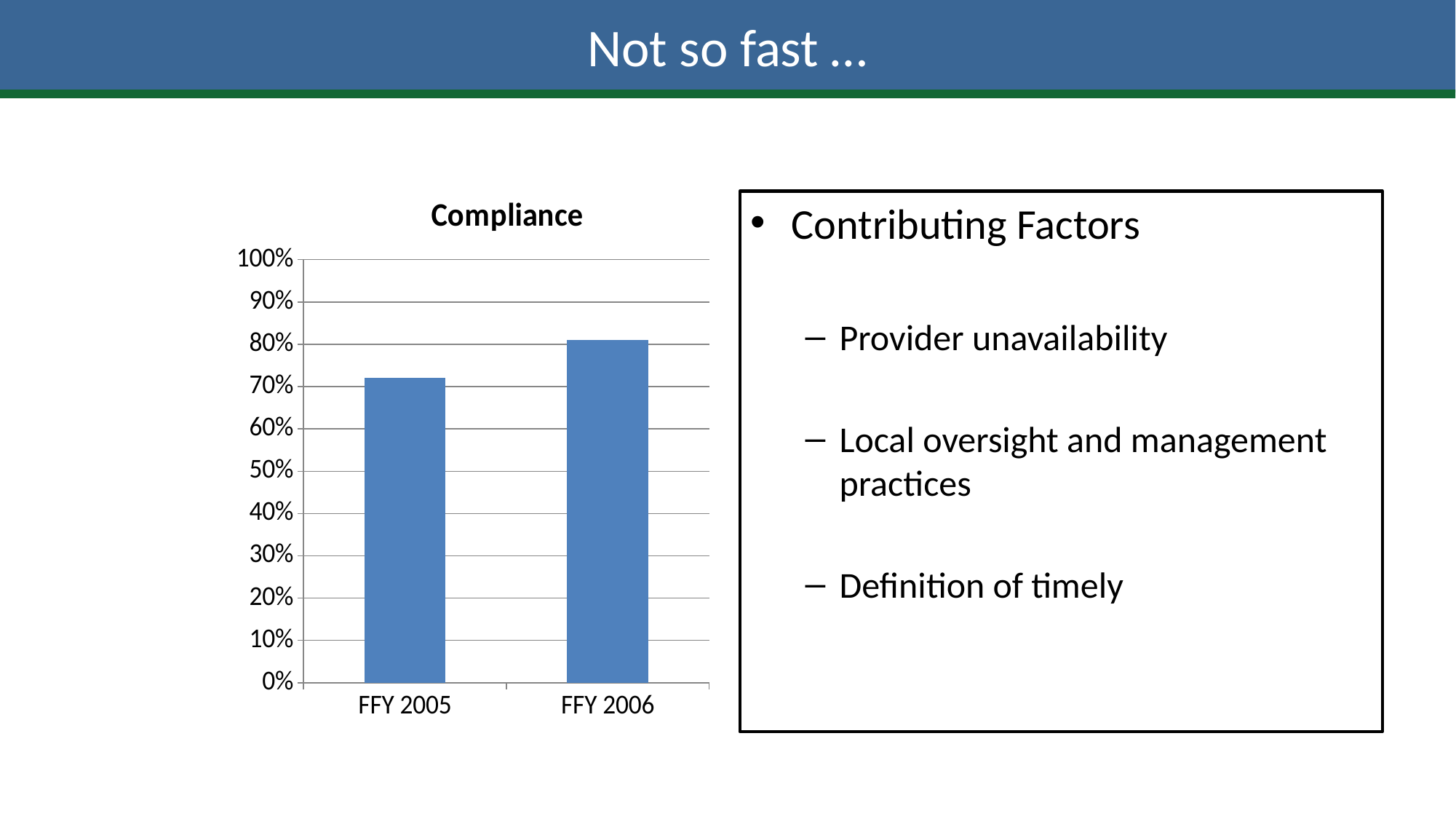
Which is larger, the value for FFY 2005 or FFY 2006? FFY 2006 Is the value for FFY 2006 greater or less than 70%? greater What is the title of the chart? Compliance Do the values rise or fall from FFY 2005 to FFY 2006? rise Is the value for FFY 2005 greater or less than 60%? greater Is the value for FFY 2005 greater or less than 80%? less Which category has the highest value in the Compliance chart? FFY 2006 What is the maximum value shown on the vertical axis of the chart? 100% What kind of chart is shown on the slide? bar chart Which category has the lowest value in the Compliance chart? FFY 2005 How many categories are plotted in the Compliance chart? 2